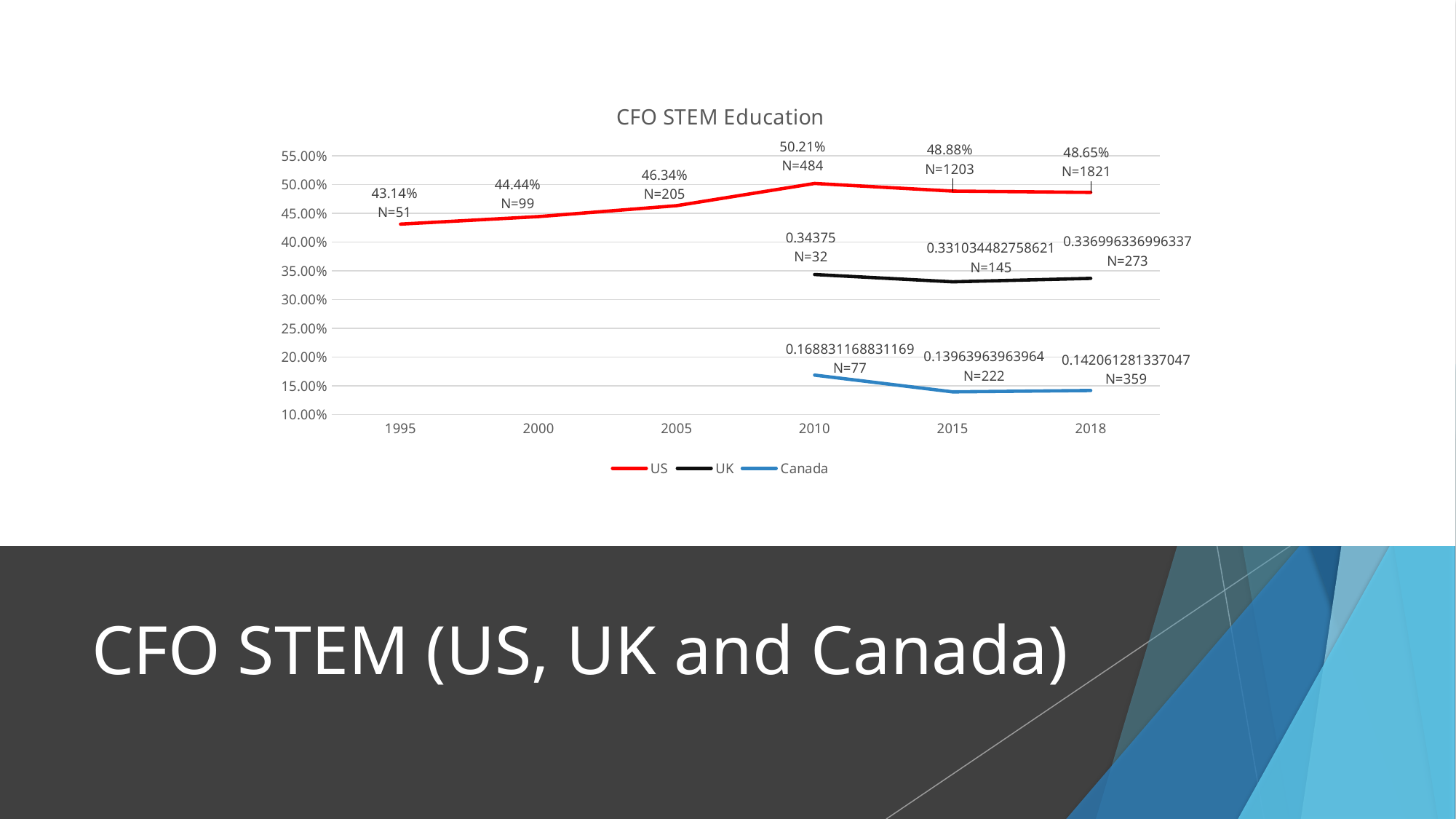
In which year is the US value highest? 2010 What type of chart is shown on the slide? line chart What is the US value in 2010? 50.21% What is the UK value in 2015? 0.331034482758621 What is the sample size (N) for Canada in 2010? N=77 What is the sample size (N) for the US in 2018? N=1821 How many series does the legend list? 3 How many years are shown on the x axis? 6 What is the title of the chart? CFO STEM Education What is the US value in 1995? 43.14% Which series has the lowest values in 2018? Canada What is the difference between the US values in 2010 and 2015? 1.33%